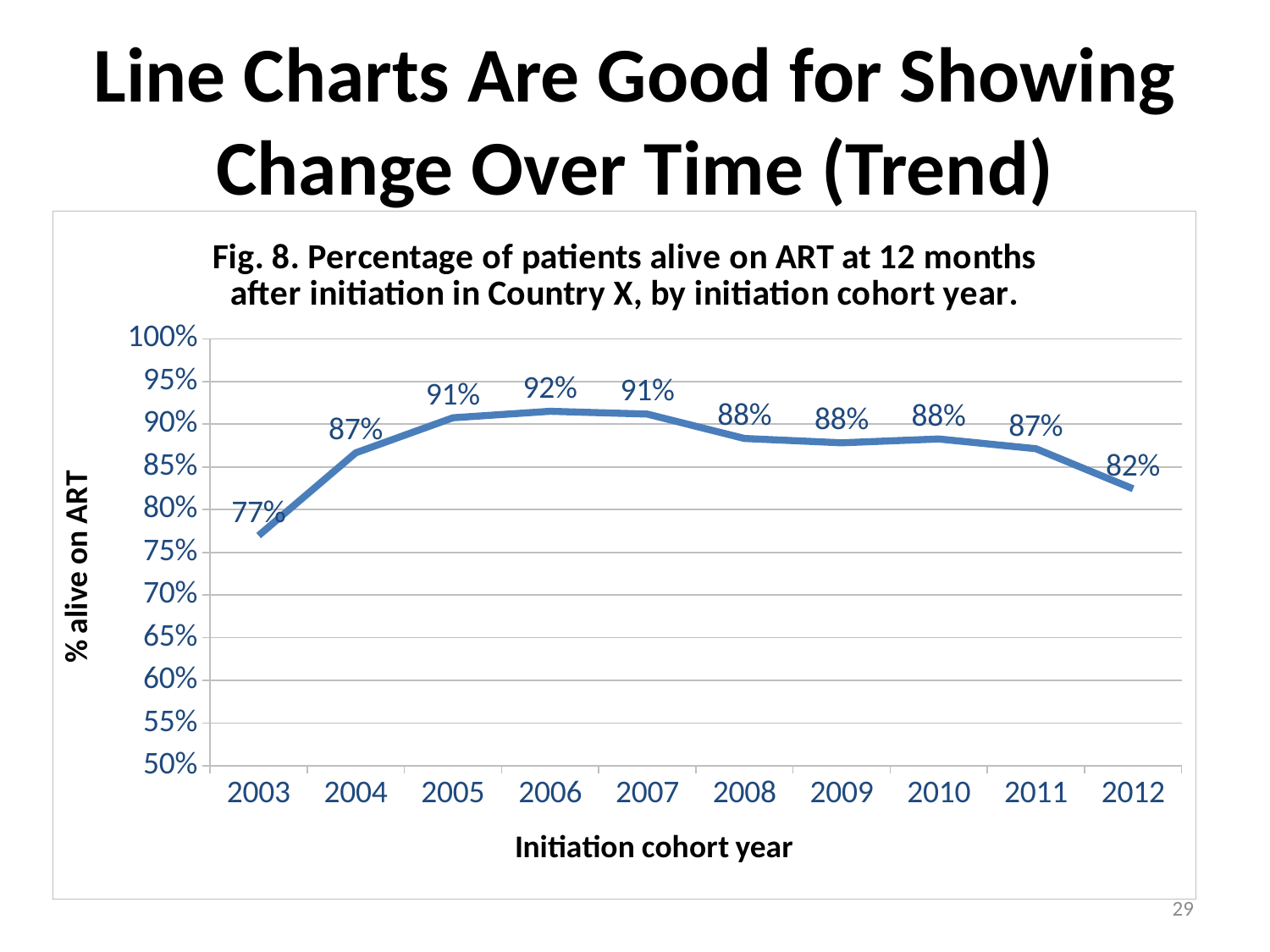
What is the label of the y axis? % alive on ART Which initiation cohort year has the lowest percentage alive on ART? 2003 Which initiation cohort year has the highest percentage alive on ART? 2006 Is the value for 2012 greater or less than 85%? less What is the value shown for the 2012 cohort year? 82% How many initiation cohort years are plotted on the chart? 10 What is the difference in percentage points between the 2011 and 2012 cohorts? 5 What is the difference in percentage points between the 2006 and 2003 cohorts? 15 Which cohort year has a higher value, 2004 or 2005? 2005 What is the value shown for the 2006 cohort year? 92% What kind of chart is shown on the slide? line chart What percentage of patients were alive on ART at 12 months for the 2003 initiation cohort? 77%